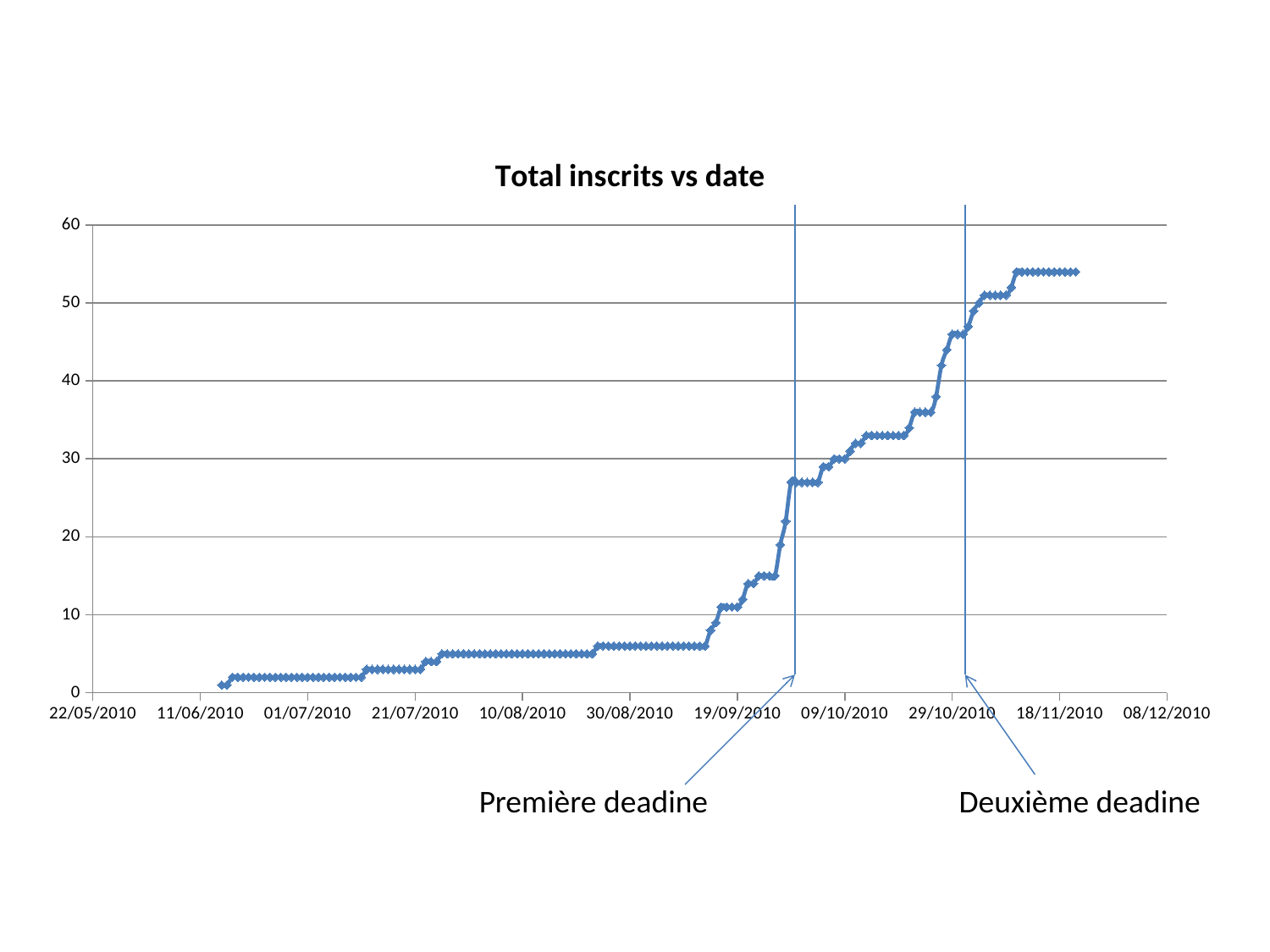
Do the values rise or fall as the date moves from left to right along the x axis? rise Is the value on 29/10/2010 greater or less than 30? greater What do the two vertical lines drawn on the chart mark? Première deadine and Deuxième deadine Is the value at the first deadline (Première deadine) greater or less than the value at the second deadline (Deuxième deadine)? less What is the title of the chart? Total inscrits vs date Is the value on 30/08/2010 greater or less than 10? less Is the value on 18/11/2010 greater or less than 50? greater What kind of chart is shown on the slide? line chart